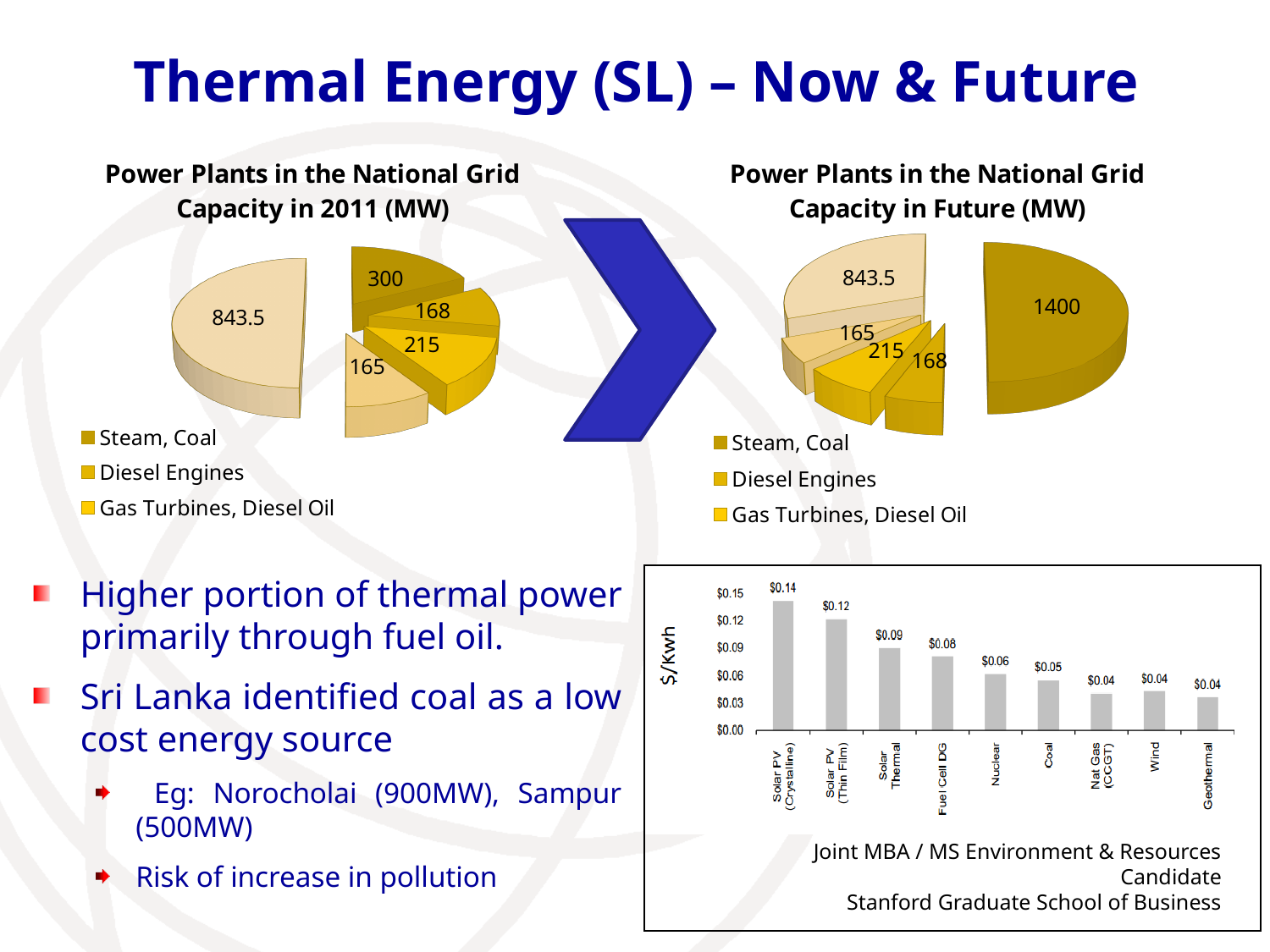
In the pie chart 'Power Plants in the National Grid Capacity in Future (MW)', what is the value of the largest slice? 1400 In the bar chart at the bottom right, which is larger: the value for Fuel Cell DG or the value for Wind? Fuel Cell DG In the bar chart at the bottom right, what is the difference between the values for Solar PV (Crystalline) and Coal? $0.09 What kind of chart is the chart at the bottom right of the slide? bar chart In the pie chart 'Power Plants in the National Grid Capacity in 2011 (MW)', how many slices are there? 5 In the bar chart at the bottom right, do the values rise or fall from left to right along the x axis? fall What is the label on the y axis of the bar chart at the bottom right? $/Kwh In the bar chart at the bottom right, which category has the highest value? Solar PV (Crystalline) In the bar chart at the bottom right, how many categories are shown on the x axis? 9 In the bar chart at the bottom right, what is the value for Nuclear? $0.06 In the pie chart 'Power Plants in the National Grid Capacity in 2011 (MW)', what is the value of the largest slice? 843.5 In the bar chart at the bottom right, what is the value for Coal? $0.05